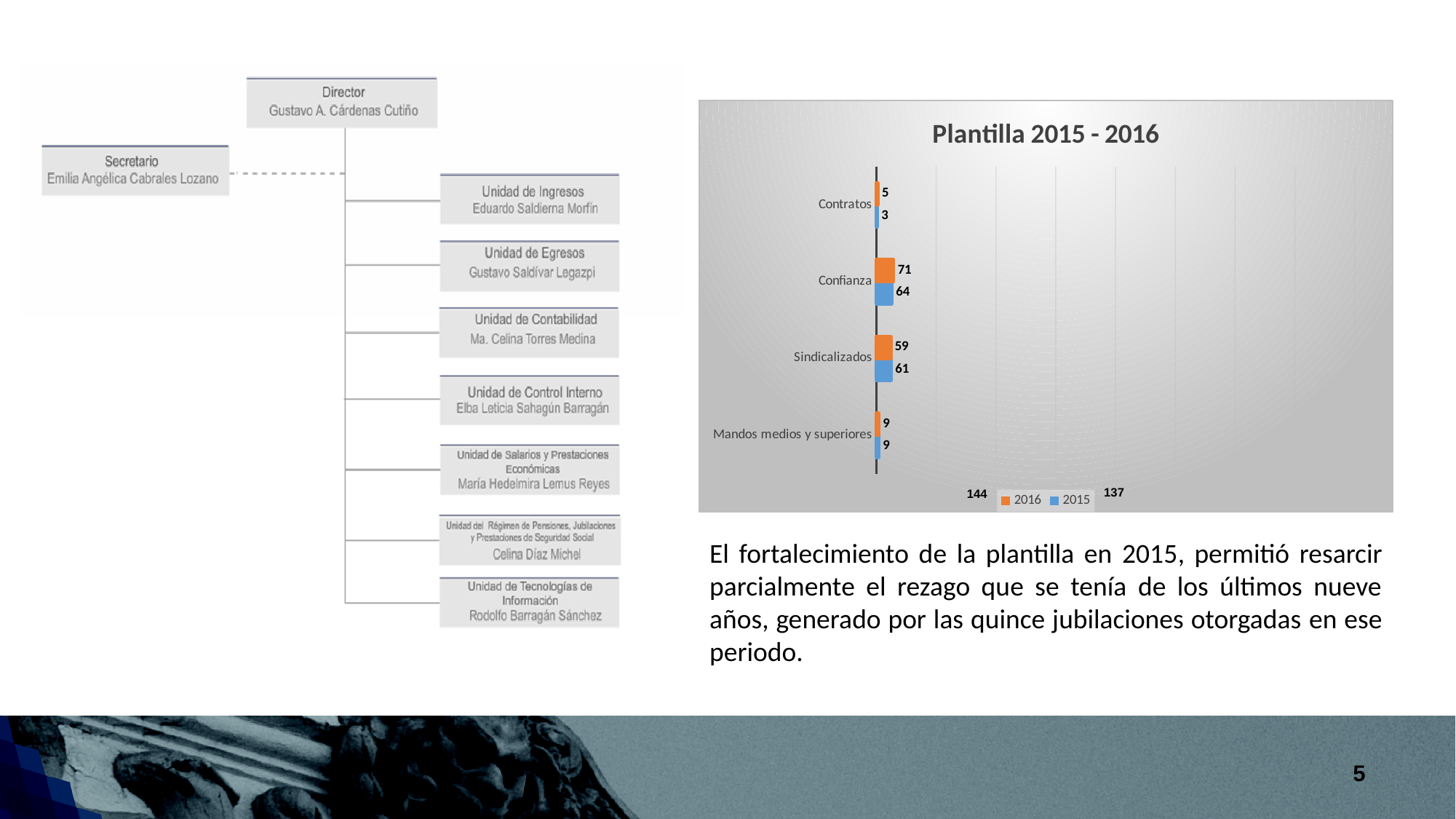
Which colour represents the 2016 series in the Plantilla 2015 - 2016 chart? orange How many series does the legend of the Plantilla 2015 - 2016 chart list? 2 How many categories are shown in the Plantilla 2015 - 2016 chart? 4 What is the title of the chart on the slide? Plantilla 2015 - 2016 What kind of chart is the Plantilla 2015 - 2016 chart? bar chart What is the 2015 value for Contratos in the Plantilla 2015 - 2016 chart? 3 Which category has the highest 2016 value in the Plantilla 2015 - 2016 chart? Confianza In the Plantilla 2015 - 2016 chart, what is the difference between the 2016 and 2015 values for Confianza? 7 What is the 2016 value for Confianza in the Plantilla 2015 - 2016 chart? 71 In the Plantilla 2015 - 2016 chart, is the 2016 value for Sindicalizados larger or smaller than the 2015 value? smaller What is the 2015 value for Sindicalizados in the Plantilla 2015 - 2016 chart? 61 Which category has the lowest 2015 value in the Plantilla 2015 - 2016 chart? Contratos